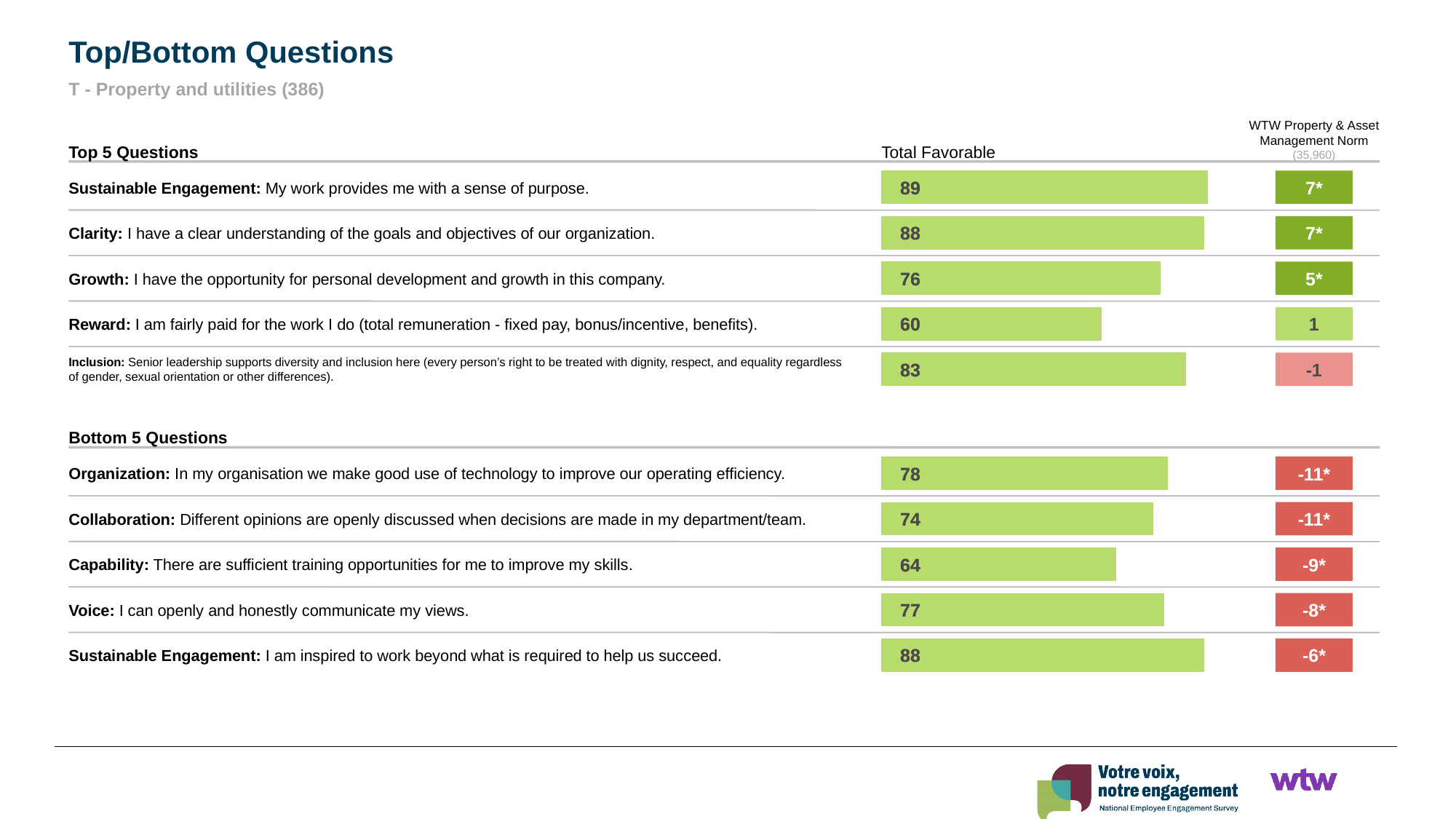
In the Top 5 Questions chart, what is the Total Favorable value for Growth? 76 In the Top 5 Questions chart, which has a higher Total Favorable value, Inclusion or Growth? Inclusion In the Top 5 Questions chart, what is the WTW Property & Asset Management Norm difference shown for Inclusion? -1 What kind of chart is used to show the Total Favorable values? Bar chart In the Top 5 Questions chart, what is the Total Favorable value for Reward? 60 In the Top 5 Questions chart, which question has the highest Total Favorable value? Sustainable Engagement: My work provides me with a sense of purpose. How many questions are listed in the Bottom 5 Questions chart? 5 In the Top 5 Questions chart, which question has the lowest Total Favorable value? Reward In the Bottom 5 Questions chart, which question has the lowest Total Favorable value? Capability In the Bottom 5 Questions chart, what is the WTW Property & Asset Management Norm difference shown for Voice? -8* In the Bottom 5 Questions chart, what is the Total Favorable value for Capability? 64 In the Bottom 5 Questions chart, what is the difference in Total Favorable between Organization and Collaboration? 4